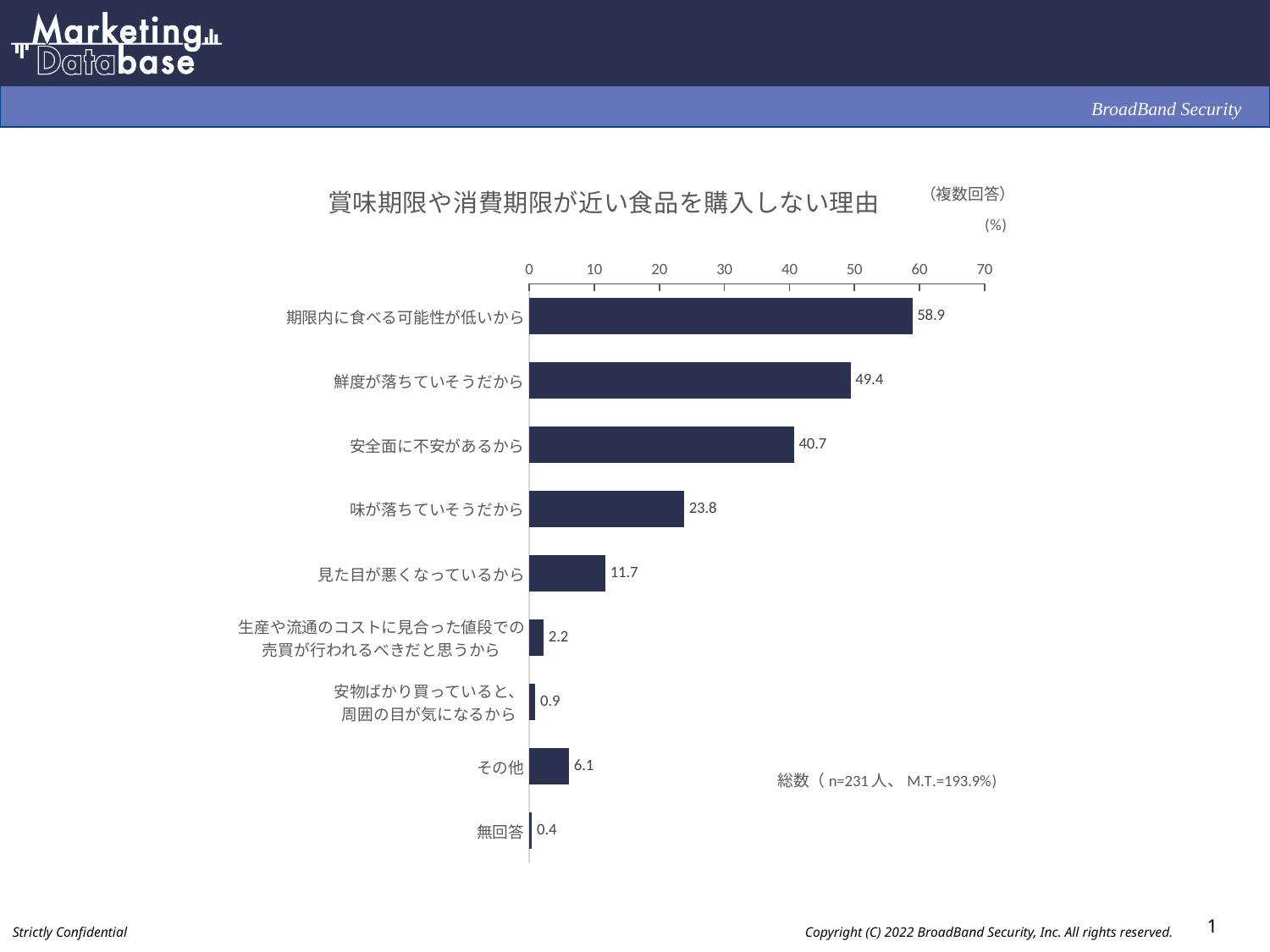
What kind of chart is shown on the slide? bar chart What is the title of the chart? 賞味期限や消費期限が近い食品を購入しない理由 What is the difference between the values for 鮮度が落ちていそうだから and 味が落ちていそうだから? 25.6 Which category has the highest value? 期限内に食べる可能性が低いから Is the value for 鮮度が落ちていそうだから greater or less than 40? greater What is the value for その他? 6.1 Which category has the lowest value? 無回答 What is the value for 見た目が悪くなっているから? 11.7 What is the value for 期限内に食べる可能性が低いから? 58.9 Which is larger, the value for 安全面に不安があるから or the value for 味が落ちていそうだから? 安全面に不安があるから What is the value for 安全面に不安があるから? 40.7 How many categories are shown in the chart? 9